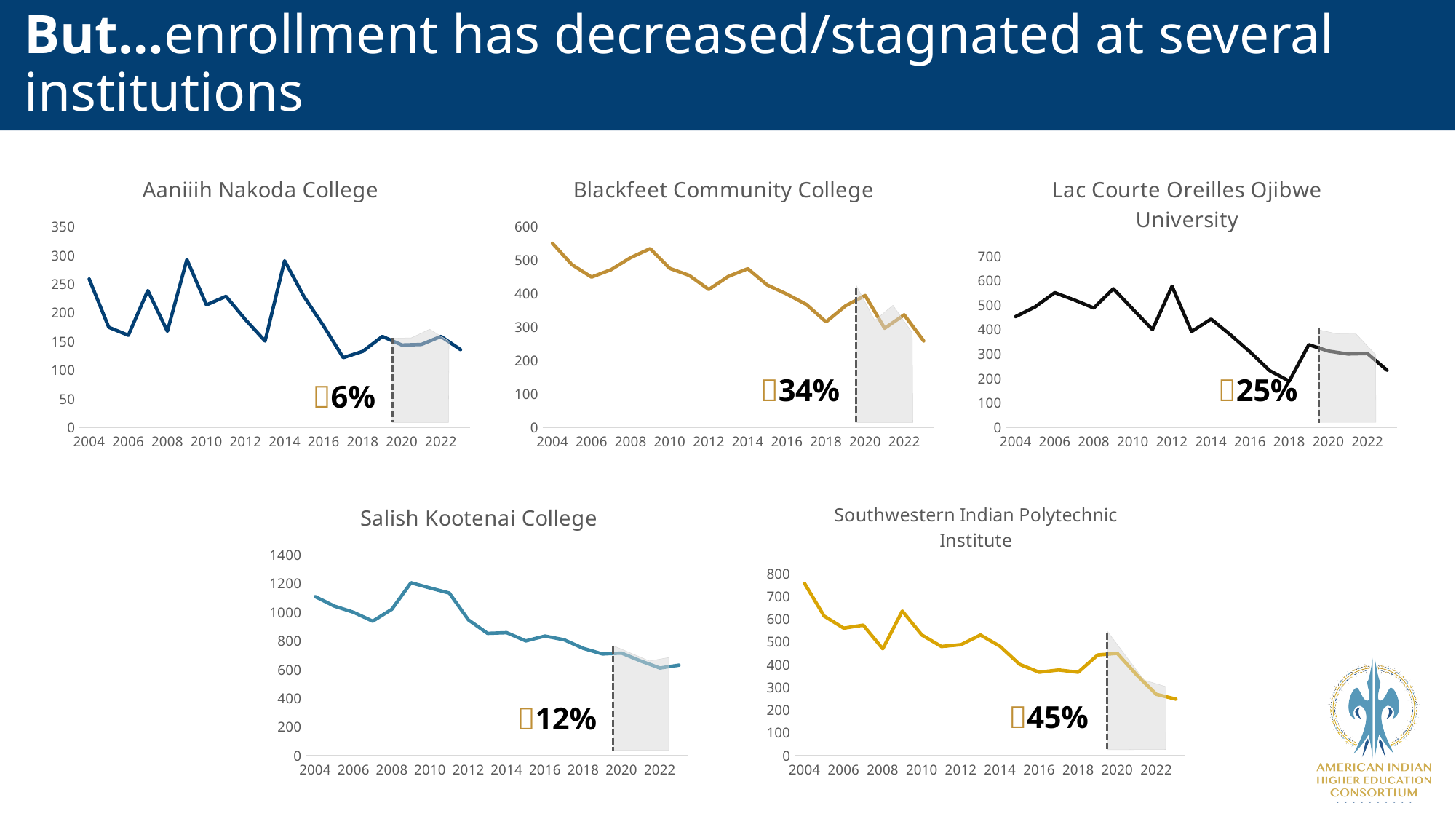
In the Southwestern Indian Polytechnic Institute chart, do the values overall rise or fall from 2004 to 2022? fall How many charts are shown on the slide? 5 In the Blackfeet Community College chart, is the value for 2004 greater or less than 500? greater What percentage is printed on the Southwestern Indian Polytechnic Institute chart? 45% In the Aaniiih Nakoda College chart, is the value for 2004 greater or less than 200? greater In the Salish Kootenai College chart, do the values overall rise or fall from 2004 to 2022? fall In the Salish Kootenai College chart, is the value for 2009 greater or less than 1000? greater In the Aaniiih Nakoda College chart, which year has the larger value, 2009 or 2013? 2009 What kind of chart is the Aaniiih Nakoda College chart? line chart What percentage is printed on the Blackfeet Community College chart? 34%